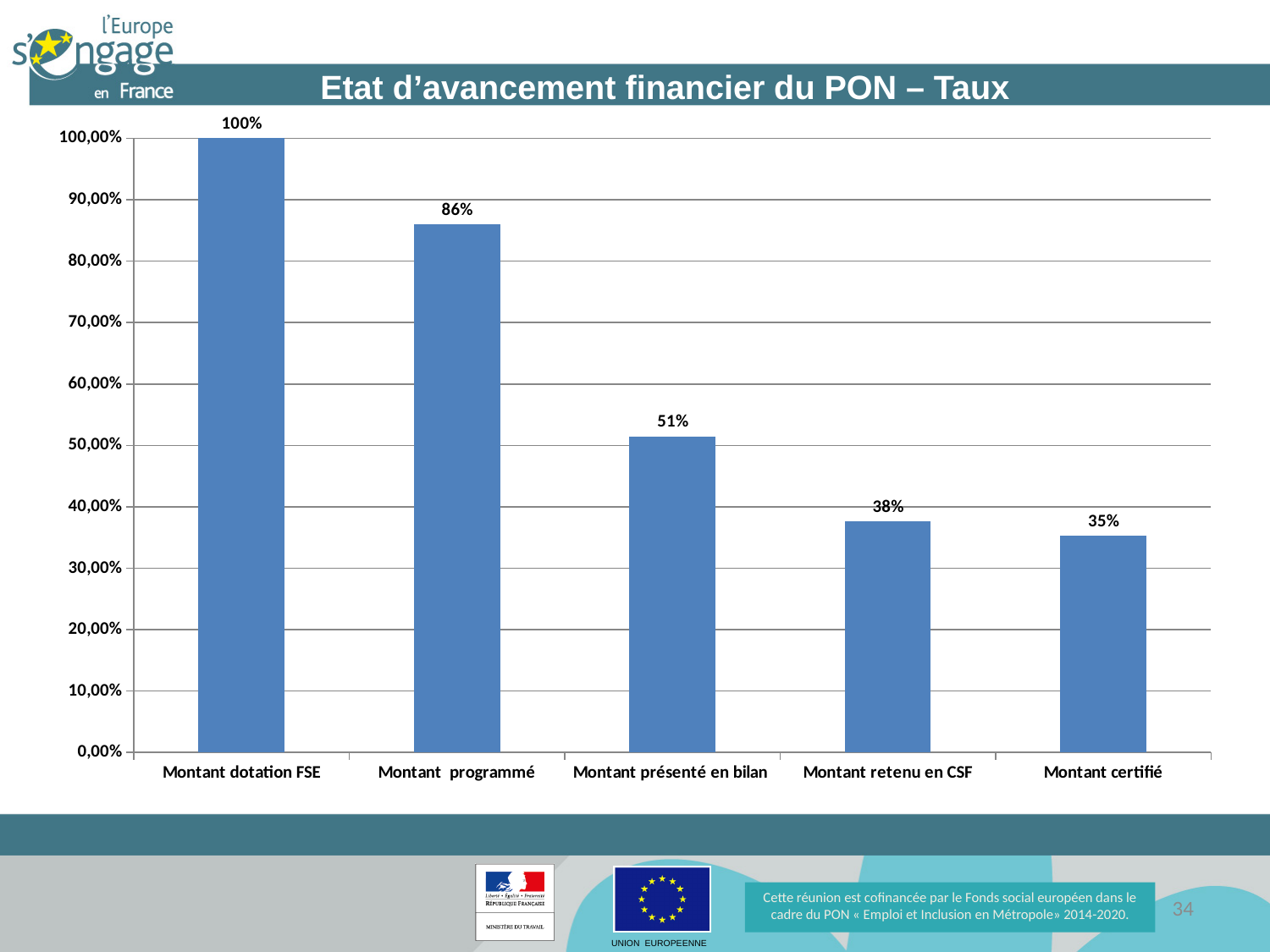
What is the value for Montant présenté en bilan? 51% What is the value for Montant programmé? 86% What is the value for Montant retenu en CSF? 38% How many categories are shown on the x axis? 5 What is the value for Montant dotation FSE? 100% Which is larger, Montant retenu en CSF or Montant certifié? Montant retenu en CSF Which category has the lowest value? Montant certifié What is the value for Montant certifié? 35% Do the values rise or fall from left to right along the x axis? Fall Which category has the highest value? Montant dotation FSE What is the difference between Montant programmé and Montant présenté en bilan? 35% What kind of chart is shown on the slide? Bar chart